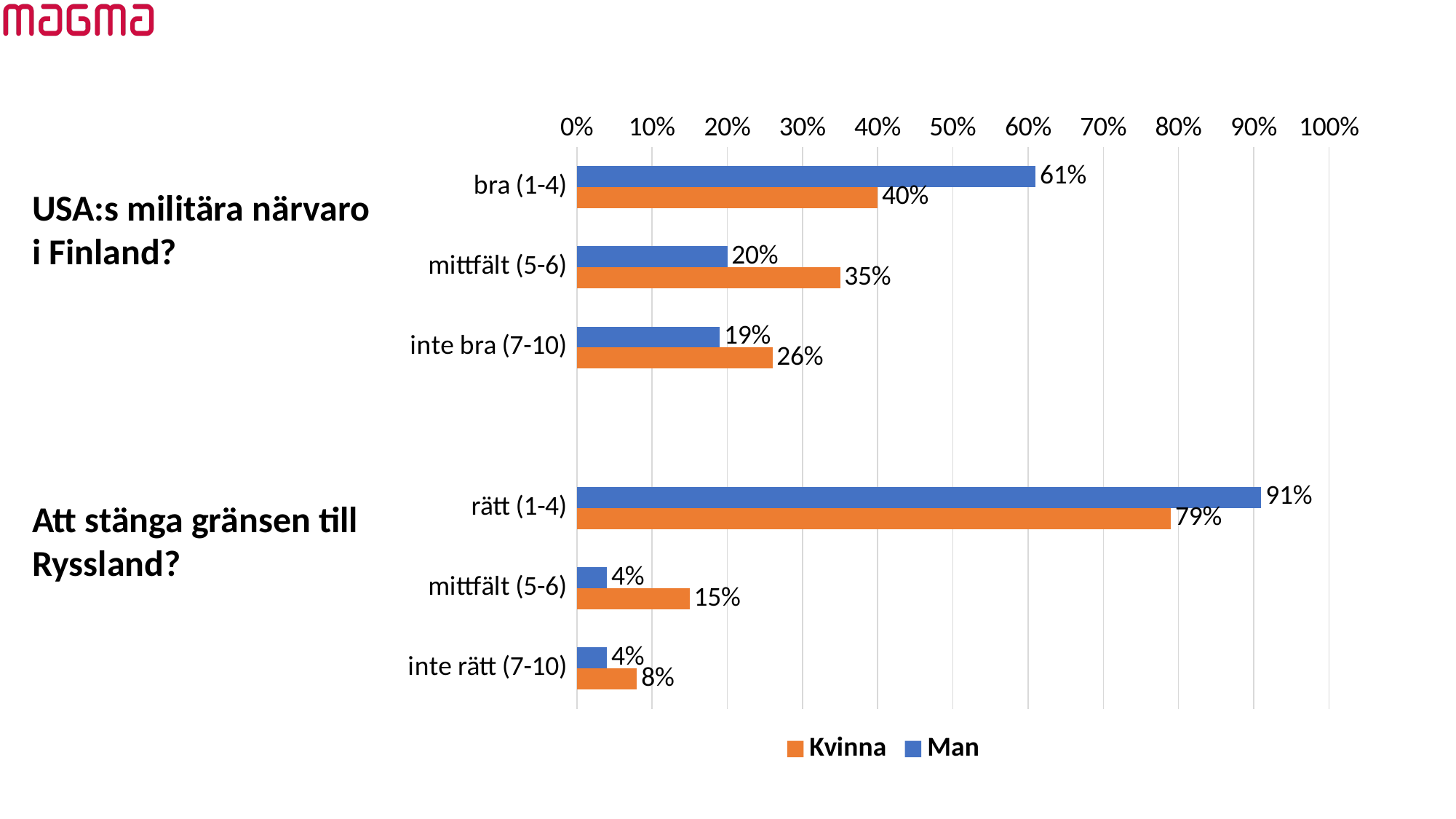
In the chart 'Att stänga gränsen till Ryssland?', which category has the lowest value for Kvinna? inte rätt (7-10) In the chart 'USA:s militära närvaro i Finland?', what is the value for Kvinna in the category 'mittfält (5-6)'? 35% In the chart 'USA:s militära närvaro i Finland?', which is larger for 'inte bra (7-10)': the Kvinna value or the Man value? Kvinna In the chart 'USA:s militära närvaro i Finland?', what is the value for Man in the category 'bra (1-4)'? 61% In the chart 'USA:s militära närvaro i Finland?', which category has the highest value for Man? bra (1-4) In the chart 'Att stänga gränsen till Ryssland?', what is the value for Man in the category 'inte rätt (7-10)'? 4% How many series does the legend list? 2 In the chart 'Att stänga gränsen till Ryssland?', what is the difference between the Man and Kvinna values for 'rätt (1-4)'? 12% How many categories does the chart 'Att stänga gränsen till Ryssland?' show? 3 What kind of chart is 'USA:s militära närvaro i Finland?'? Bar chart In the chart 'Att stänga gränsen till Ryssland?', what is the value for Kvinna in the category 'rätt (1-4)'? 79% In the chart 'USA:s militära närvaro i Finland?', what is the difference between the Man and Kvinna values for 'bra (1-4)'? 21%